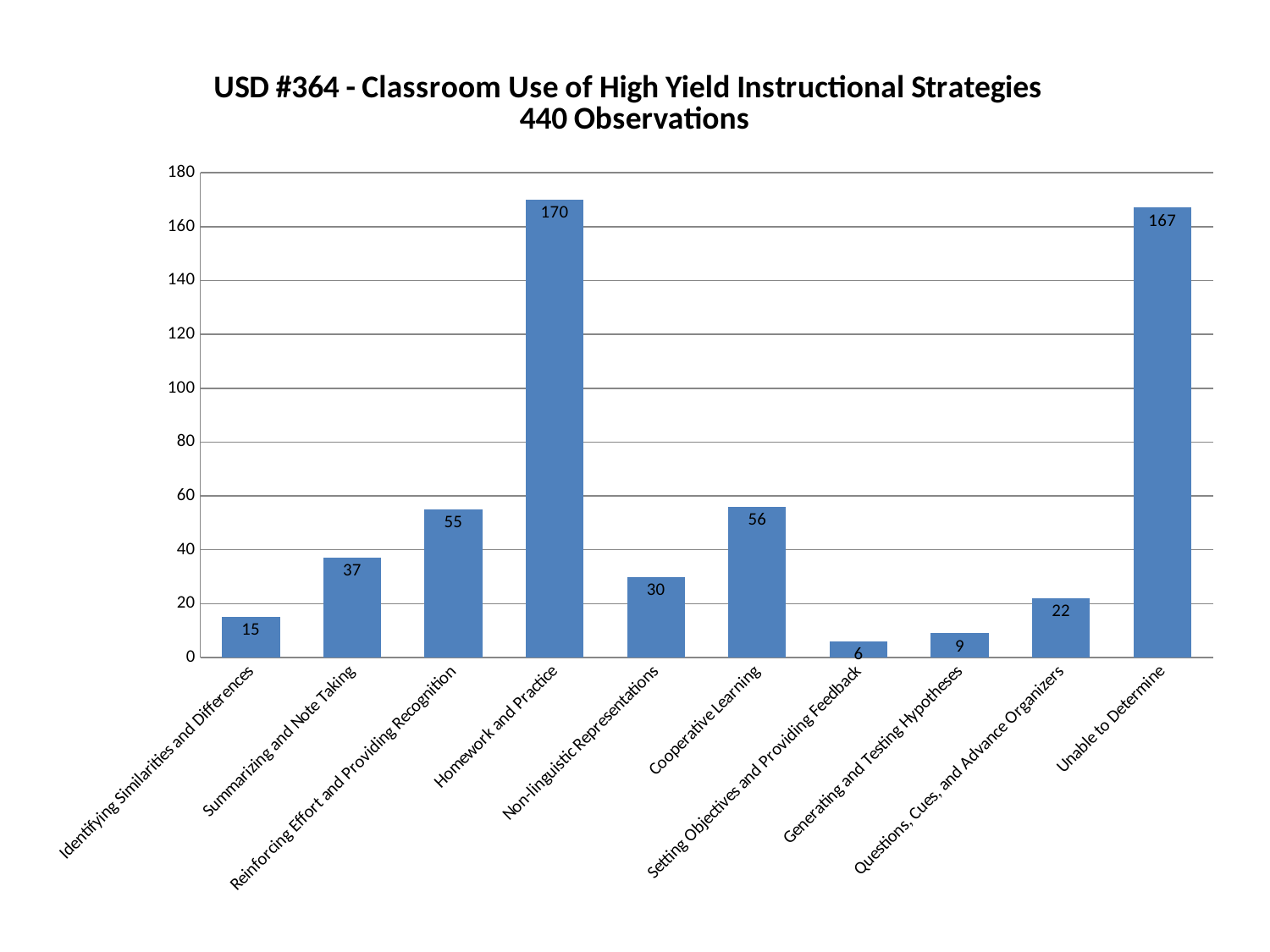
What kind of chart is shown on the slide? Bar chart What is the difference between the values for Homework and Practice and Unable to Determine? 3 What is the value for Setting Objectives and Providing Feedback? 6 Which is larger, the value for Non-linguistic Representations or the value for Questions, Cues, and Advance Organizers? Non-linguistic Representations How many categories are shown on the x axis? 10 What is the value for Unable to Determine? 167 What is the value for Cooperative Learning? 56 What is the value for Homework and Practice? 170 How many observations does the chart title say were made? 440 Which category has the lowest value? Setting Objectives and Providing Feedback Which category has the highest value? Homework and Practice What is the difference between the values for Reinforcing Effort and Providing Recognition and Summarizing and Note Taking? 18